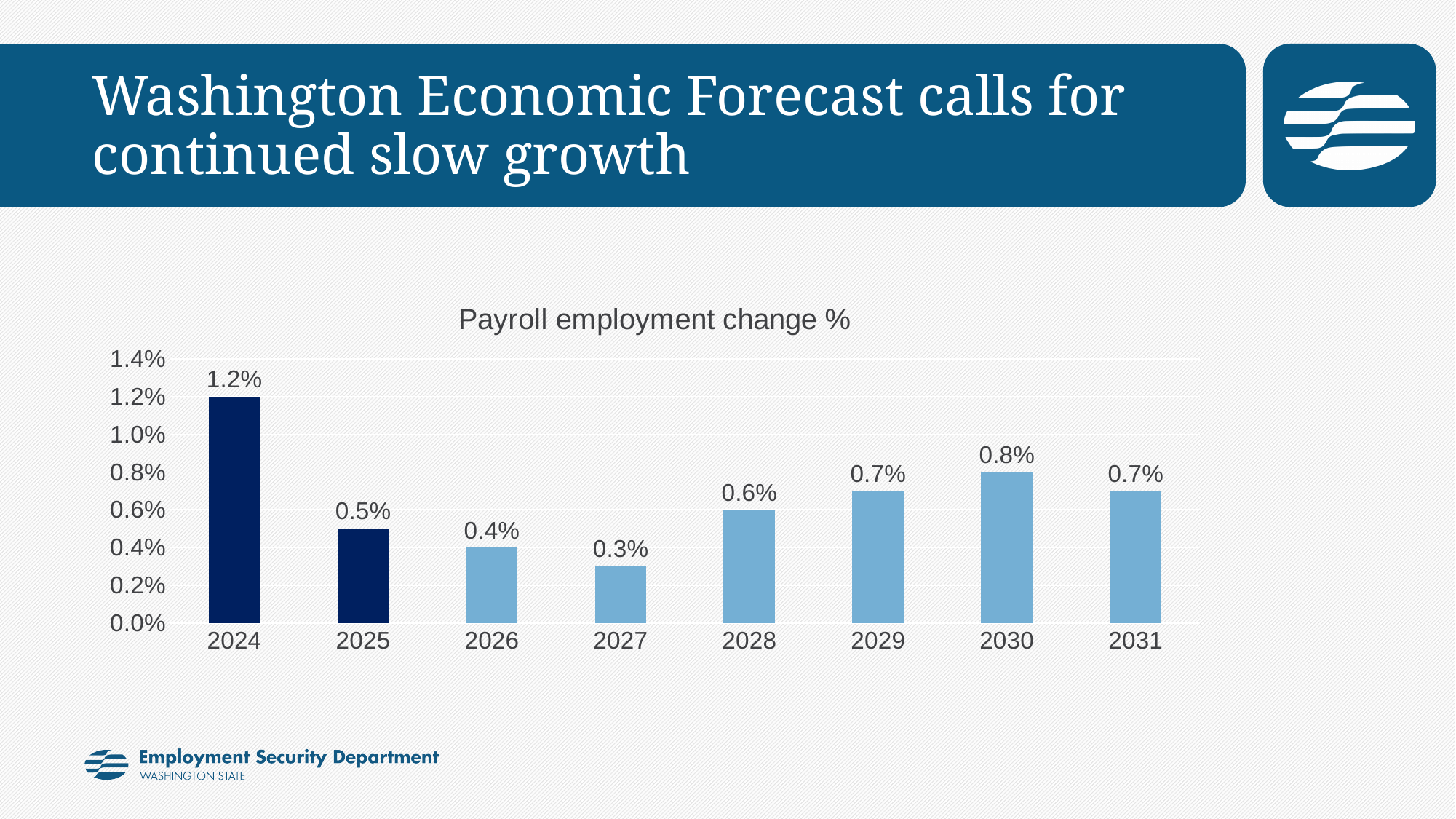
What is the payroll employment change for 2024? 1.2% What kind of chart is shown on the slide? Bar chart What is the payroll employment change for 2027? 0.3% What is the payroll employment change for 2030? 0.8% What is the difference between the payroll employment change in 2024 and 2025? 0.7% Which year has the lowest payroll employment change? 2027 How many years are shown on the chart? 8 Does the payroll employment change rise or fall from 2024 to 2027? Fall What is the title of the chart? Payroll employment change % Which year has a larger payroll employment change, 2028 or 2030? 2030 Which year has the highest payroll employment change? 2024 Is the value for 2029 greater or less than 1.0%? less